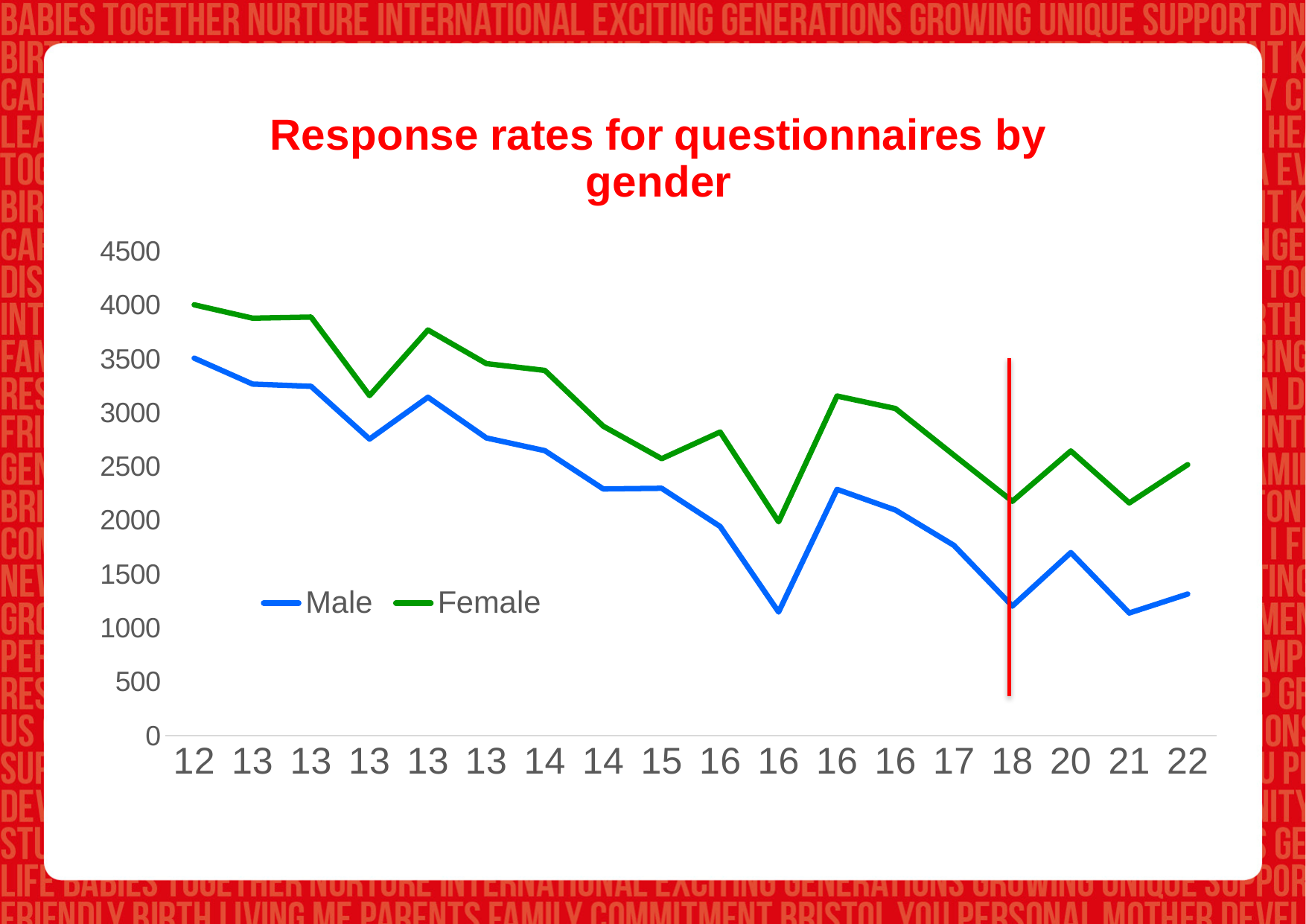
Is the Female value at the point labelled 20 greater or less than 2500? greater How many data points are plotted along the x axis for each series? 18 At which x-axis label does the Male series reach its highest value? 12 Is the Male value at the point labelled 22 greater or less than 1500? less Which series has the higher value at the point labelled 22, Male or Female? Female Is the Female value at the point labelled 12 greater or less than 3500? greater How many series does the legend list? 2 Overall, do the Male response rates rise or fall from left to right along the x axis? Fall What kind of chart is shown on the slide? Line chart At which x-axis label does the Female series reach its highest value? 12 Which colour is used for the Female series? Green